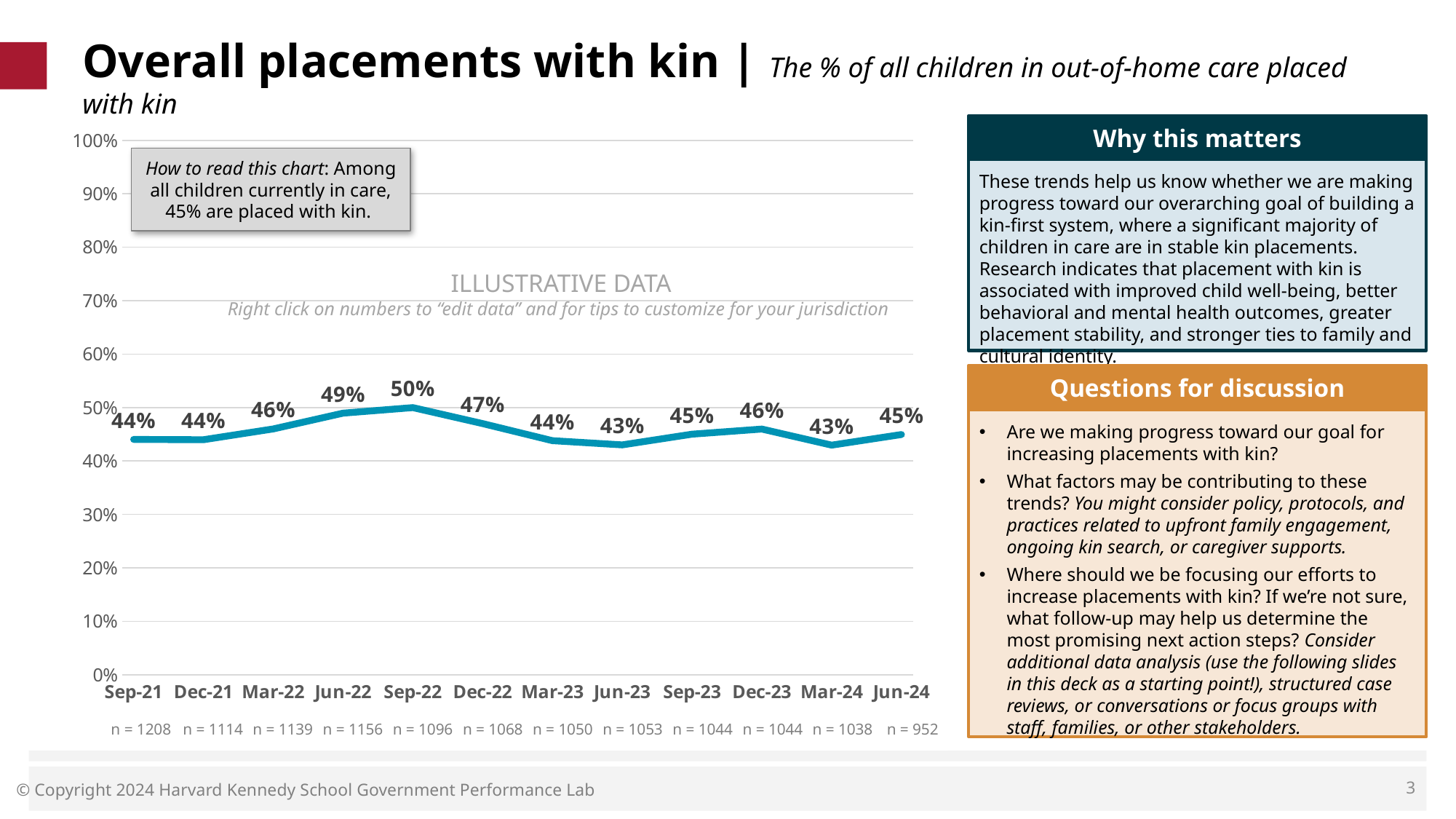
What is the value for Mar-22? 46% Does the value rise or fall from Sep-22 to Dec-22? Fall What is the value for Jun-24? 45% What percentage of children in out-of-home care were placed with kin in Sep-22? 50% Which period has the highest percentage of placements with kin? Sep-22 How many time periods are plotted on the chart? 12 Which is larger, the value for Jun-22 or the value for Dec-22? Jun-22 Is the value for Dec-23 greater or less than 40%? greater What is the sample size (n) shown for Jun-24? n = 952 What is the lowest value shown on the chart? 43% What is the difference between the values for Sep-22 and Jun-23? 7 percentage points What kind of chart is shown on the slide? Line chart